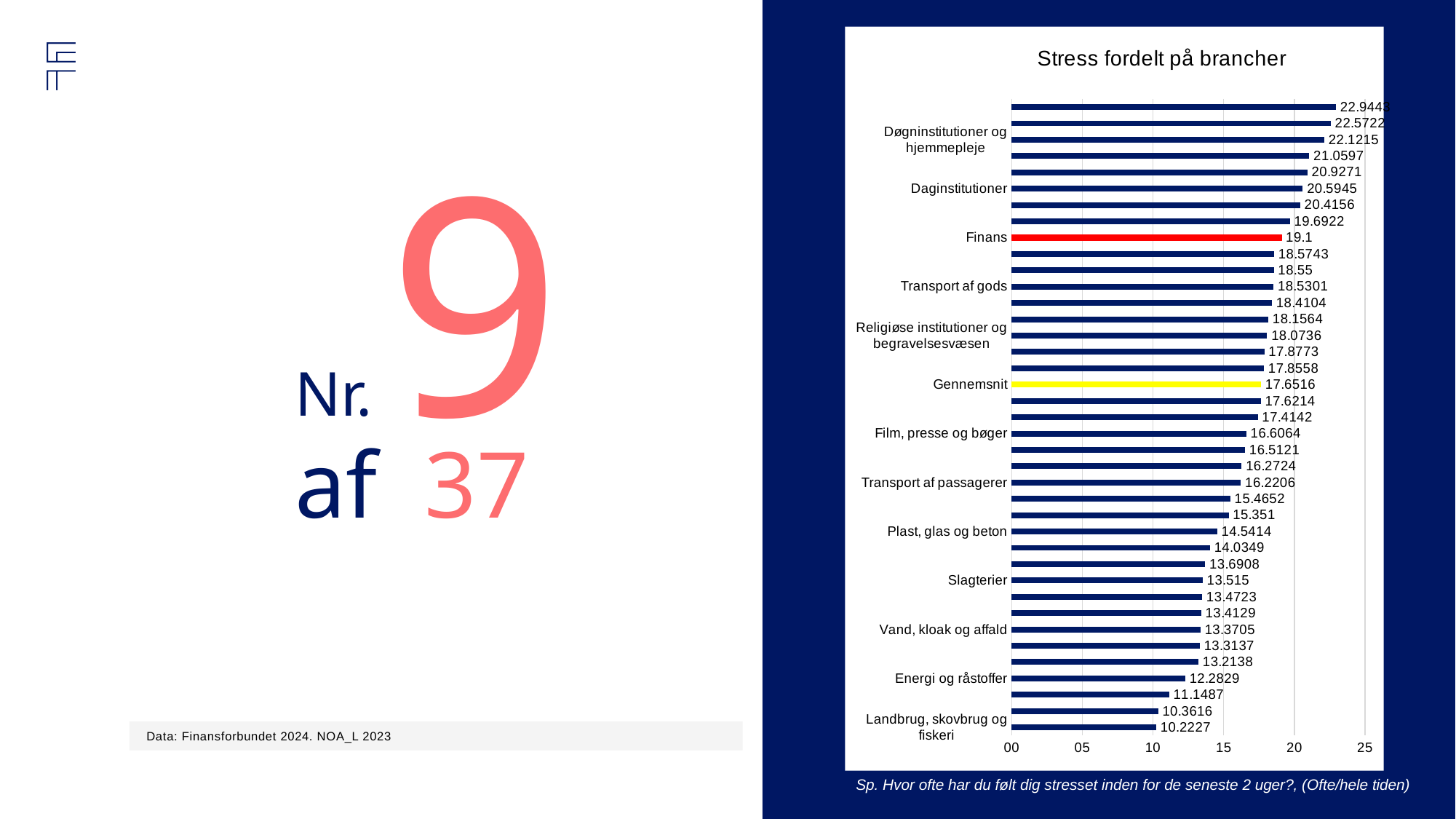
What is the value for Finans in the 'Stress fordelt på brancher' chart? 19.1 Which labelled category has the lowest value in the chart? Landbrug, skovbrug og fiskeri What is the value for Landbrug, skovbrug og fiskeri? 10.2227 Is the value for Energi og råstoffer greater or less than 15? less What is the value for Slagterier? 13.515 What is the difference between the value for Finans and the value for Gennemsnit? 1.4484 What colour is the bar for Finans? red What is the value for Daginstitutioner? 20.5945 What is the title of the chart? Stress fordelt på brancher Which is larger, the value for Finans or the value for Gennemsnit? Finans What kind of chart is shown on the slide? bar chart What is the value for Gennemsnit in the chart? 17.6516